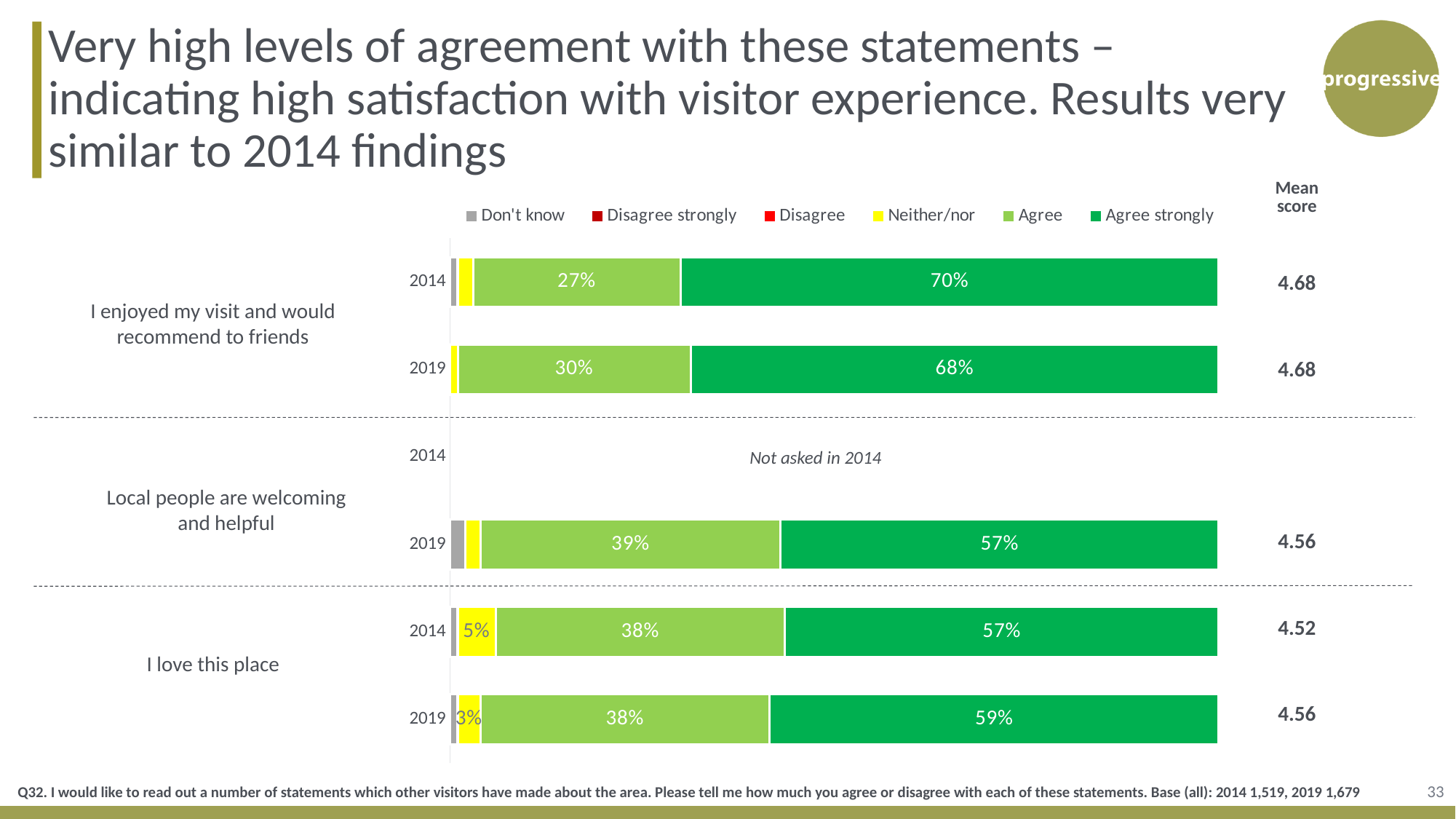
What is the 'Neither/nor' percentage for 'I love this place' in 2014? 5% What is the 'Agree strongly' percentage for 'Local people are welcoming and helpful' in 2019? 57% Why is there no bar for 'Local people are welcoming and helpful' in 2014? Not asked in 2014 How many series does the legend list? 6 What is the mean score for 'I love this place' in 2014? 4.52 What kind of chart is shown on the slide? Stacked bar chart For 'I love this place', which year has the larger 'Agree strongly' percentage, 2014 or 2019? 2019 What is the mean score for 'Local people are welcoming and helpful' in 2019? 4.56 What is the difference in percentage points between the 'Agree strongly' values for 'I enjoyed my visit and would recommend to friends' in 2014 and 2019? 2 percentage points What percentage of respondents in 2019 agreed (not strongly) with 'I enjoyed my visit and would recommend to friends'? 30% Which statement and year has the highest 'Agree strongly' percentage? I enjoyed my visit and would recommend to friends, 2014 What percentage of respondents in 2014 agreed strongly with 'I enjoyed my visit and would recommend to friends'? 70%